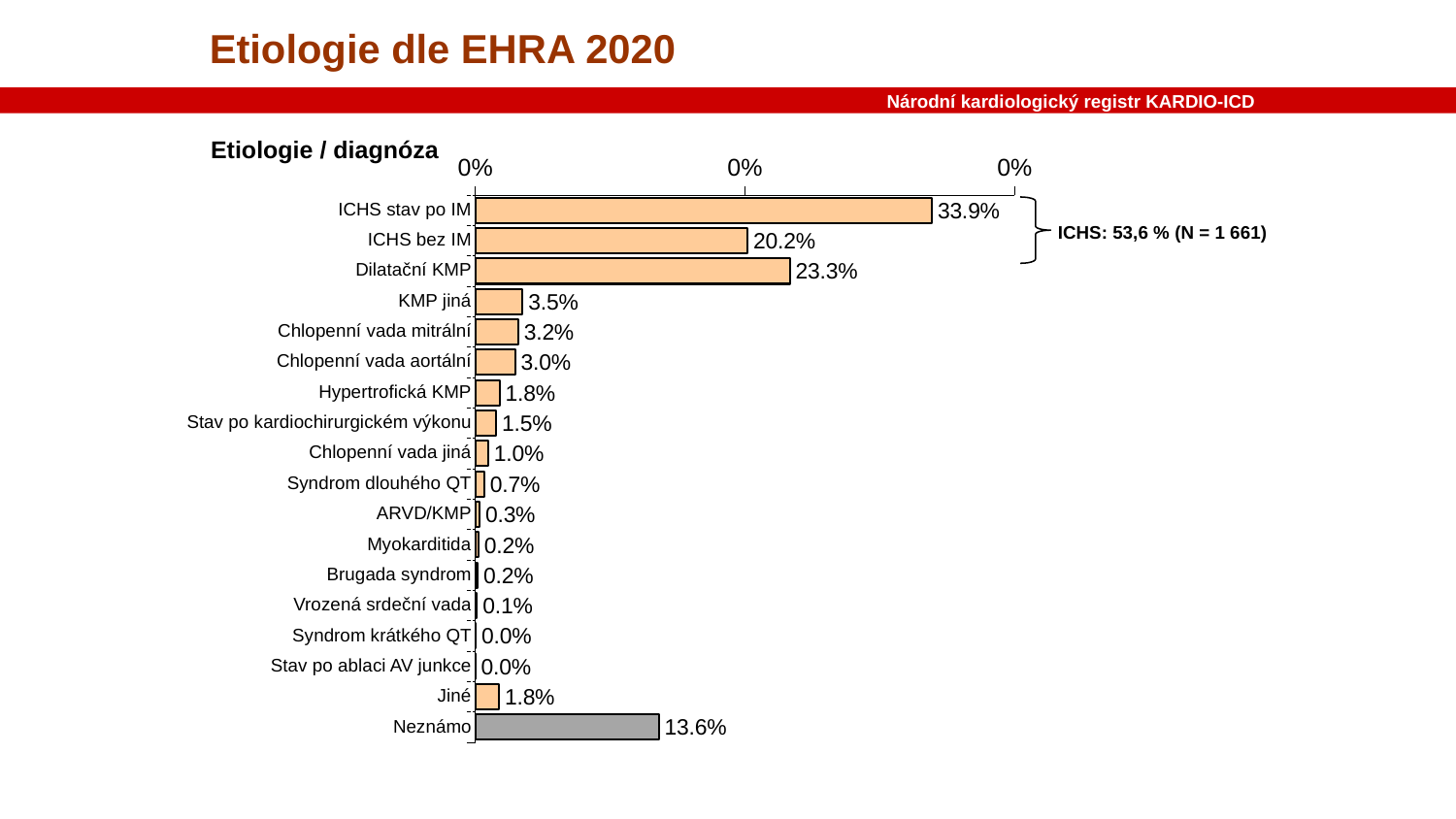
What is the difference between the values for ICHS stav po IM and ICHS bez IM? 13.7% What is the value for Dilatační KMP? 23.3% What is the combined value of ICHS stav po IM and ICHS bez IM as stated in the annotation on the chart? ICHS: 53,6 % (N = 1 661) What is the title of the chart? Etiologie / diagnóza Which is larger, the value for KMP jiná or the value for Hypertrofická KMP? KMP jiná What is the value for Chlopenní vada aortální? 3.0% Which is larger, the value for Dilatační KMP or the value for ICHS bez IM? Dilatační KMP What type of chart is shown on the slide? bar chart What is the value for ICHS stav po IM? 33.9% Which category has the highest value? ICHS stav po IM How many categories are shown in the chart? 18 What is the value for Neznámo? 13.6%